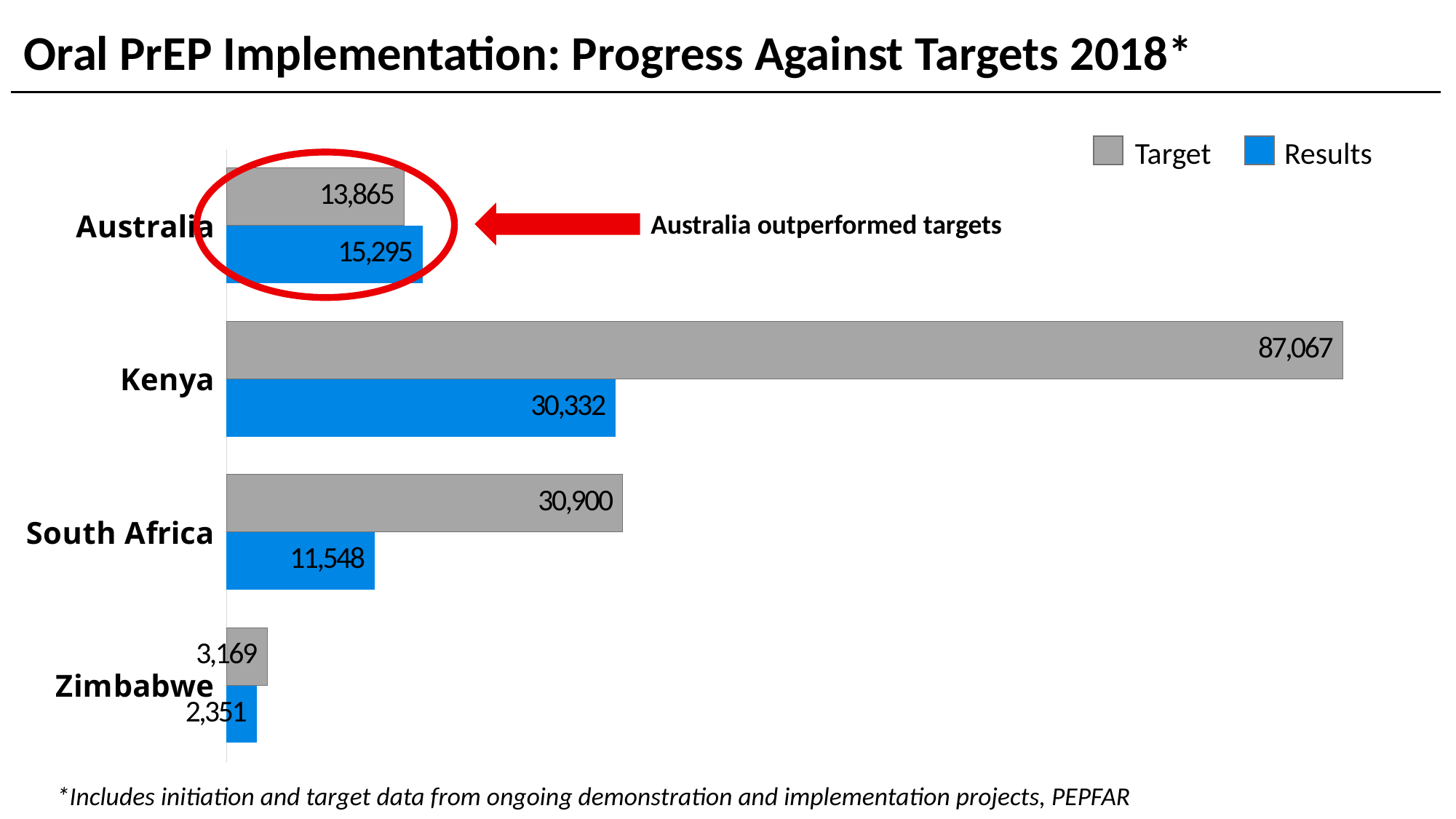
What is the Results value for Australia? 15,295 What is the difference between the Results and Target values for Australia? 1,430 What is the Target value for Zimbabwe? 3,169 What is the Results value for South Africa? 11,548 What is the difference between the Target and Results values for Kenya? 56,735 What type of chart is shown on the slide? Bar chart What is the Target value for Kenya? 87,067 How many series does the legend list? 2 How many countries are shown in the chart? 4 Which country has the highest Target value? Kenya Which country has the lowest Results value? Zimbabwe Which is larger for South Africa, the Target or the Results value? Target